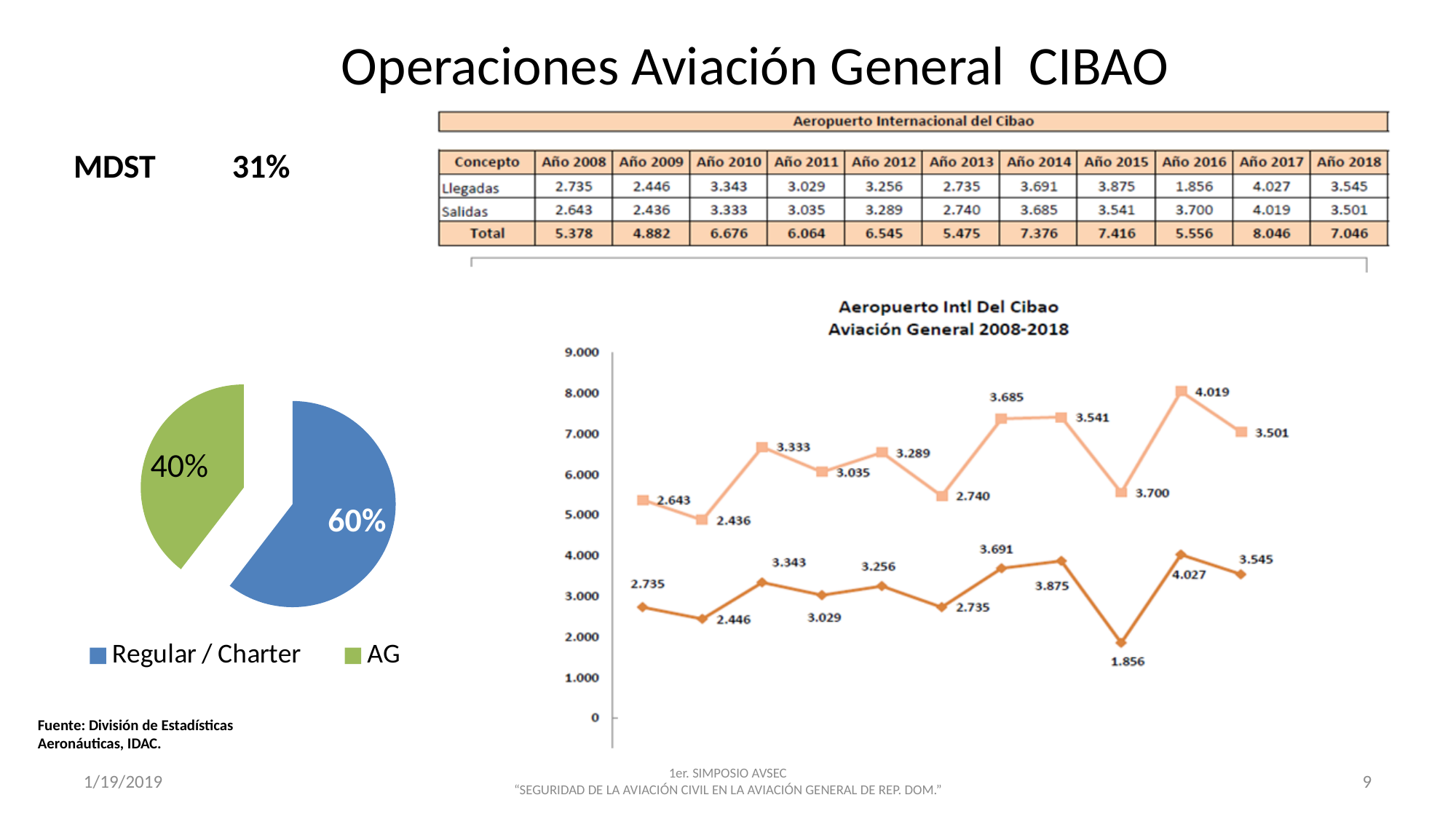
In the line chart, how many data points are plotted on the lower (dark orange) line? 11 In the pie chart, what share does Regular / Charter have? 60% In the line chart, is the lowest point of the lower (dark orange) line greater or less than 2.000 on the y axis? less In the pie chart, which slice is larger, Regular / Charter or AG? Regular / Charter In the pie chart, what share does AG have? 40% In the line chart, what is the highest labeled value on the lower (dark orange) line? 4.027 What kind of chart is the chart titled 'Aeropuerto Intl Del Cibao Aviación General 2008-2018'? Line chart How many slices does the pie chart have? 2 In the line chart, what is the label of the first point on the lower (dark orange) line? 2.735 What kind of chart is the chart on the left of the slide? Pie chart In the line chart, what is the highest labeled value on the upper (light orange) line? 4.019 In the line chart, what is the lowest labeled value on the lower (dark orange) line? 1.856